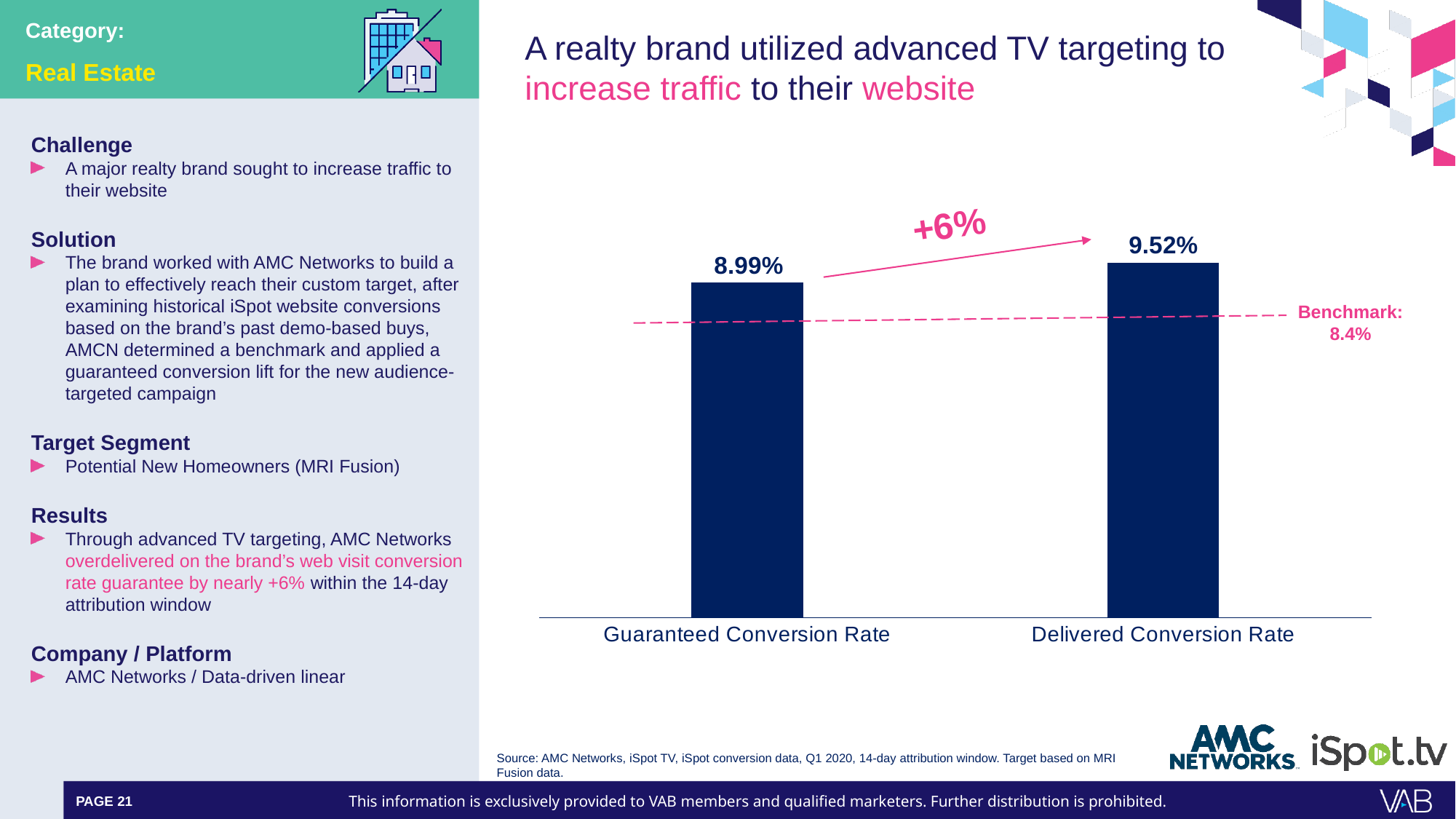
Which category has the lower value? Guaranteed Conversion Rate What is the value for Delivered Conversion Rate? 9.52% What kind of chart is shown on the slide? bar chart What is the value for Guaranteed Conversion Rate? 8.99% What percentage change is labelled on the arrow between the two bars? +6% What benchmark value is marked by the dashed line on the chart? 8.4% Is the Delivered Conversion Rate larger or smaller than the Guaranteed Conversion Rate? larger How many bars are plotted in the chart? 2 Do the values rise or fall from Guaranteed Conversion Rate to Delivered Conversion Rate? rise Which category has the higher value? Delivered Conversion Rate What is the difference between the Delivered Conversion Rate and the Guaranteed Conversion Rate? 0.53%